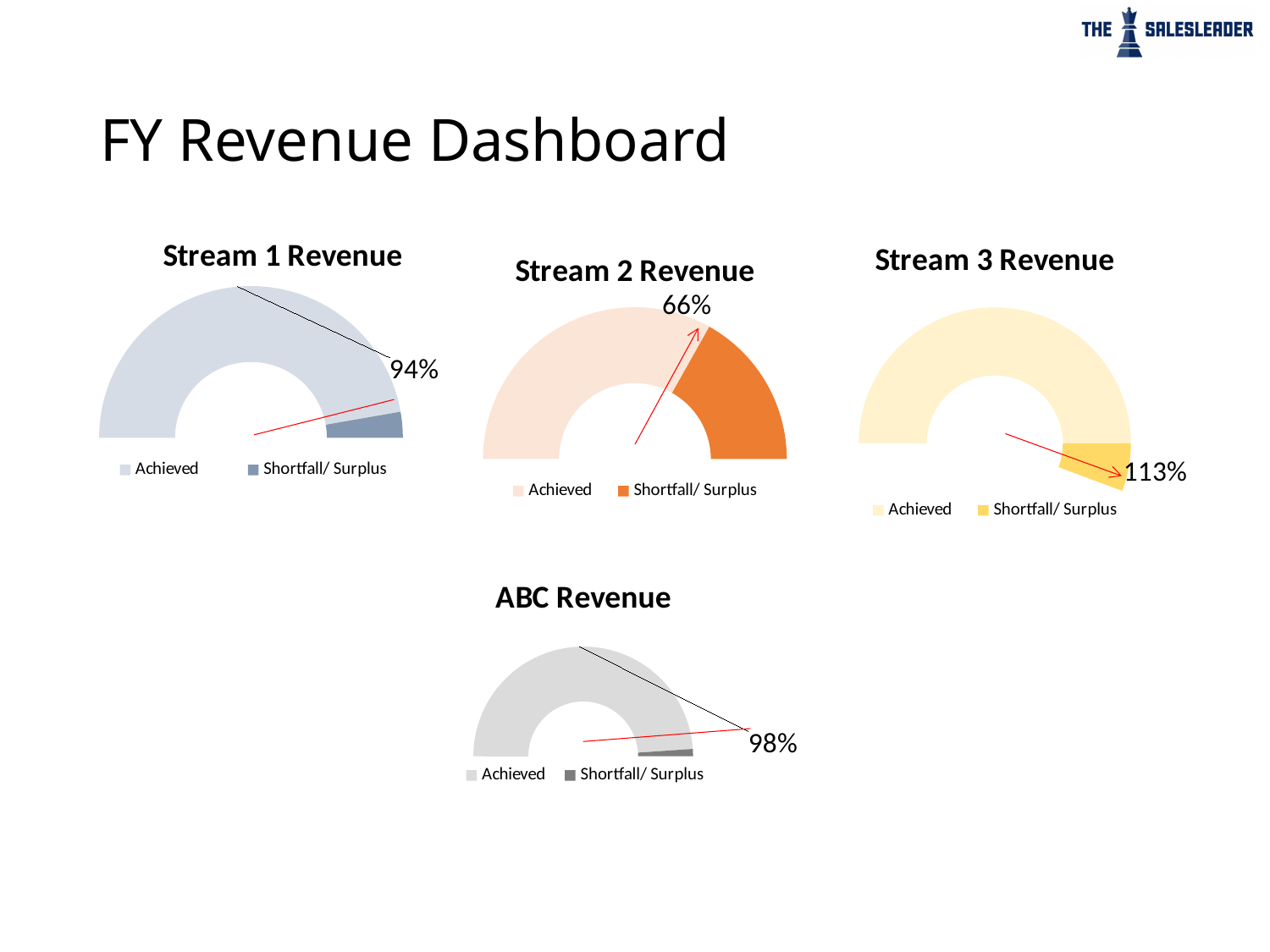
What kind of chart is the Stream 1 Revenue chart? Doughnut (gauge) chart On the Stream 3 Revenue chart, what percentage is shown as the data label? 113% On the Stream 3 Revenue chart, what are the two legend entries? Achieved and Shortfall/ Surplus Across the four charts on the slide, which chart shows the lowest percentage label? Stream 2 Revenue What is the difference between the percentage shown on the Stream 3 Revenue chart and the percentage shown on the Stream 2 Revenue chart? 47 percentage points On the Stream 1 Revenue chart, what percentage is shown as the data label? 94% How many charts are shown on the slide? 4 Which shows a larger percentage, the Stream 1 Revenue chart or the ABC Revenue chart? ABC Revenue On the ABC Revenue chart, what percentage is shown as the data label? 98% On the Stream 2 Revenue chart, what percentage is shown as the data label? 66% On the Stream 2 Revenue chart, how many entries does the legend list? 2 Across the four charts on the slide, which chart shows the highest percentage label? Stream 3 Revenue